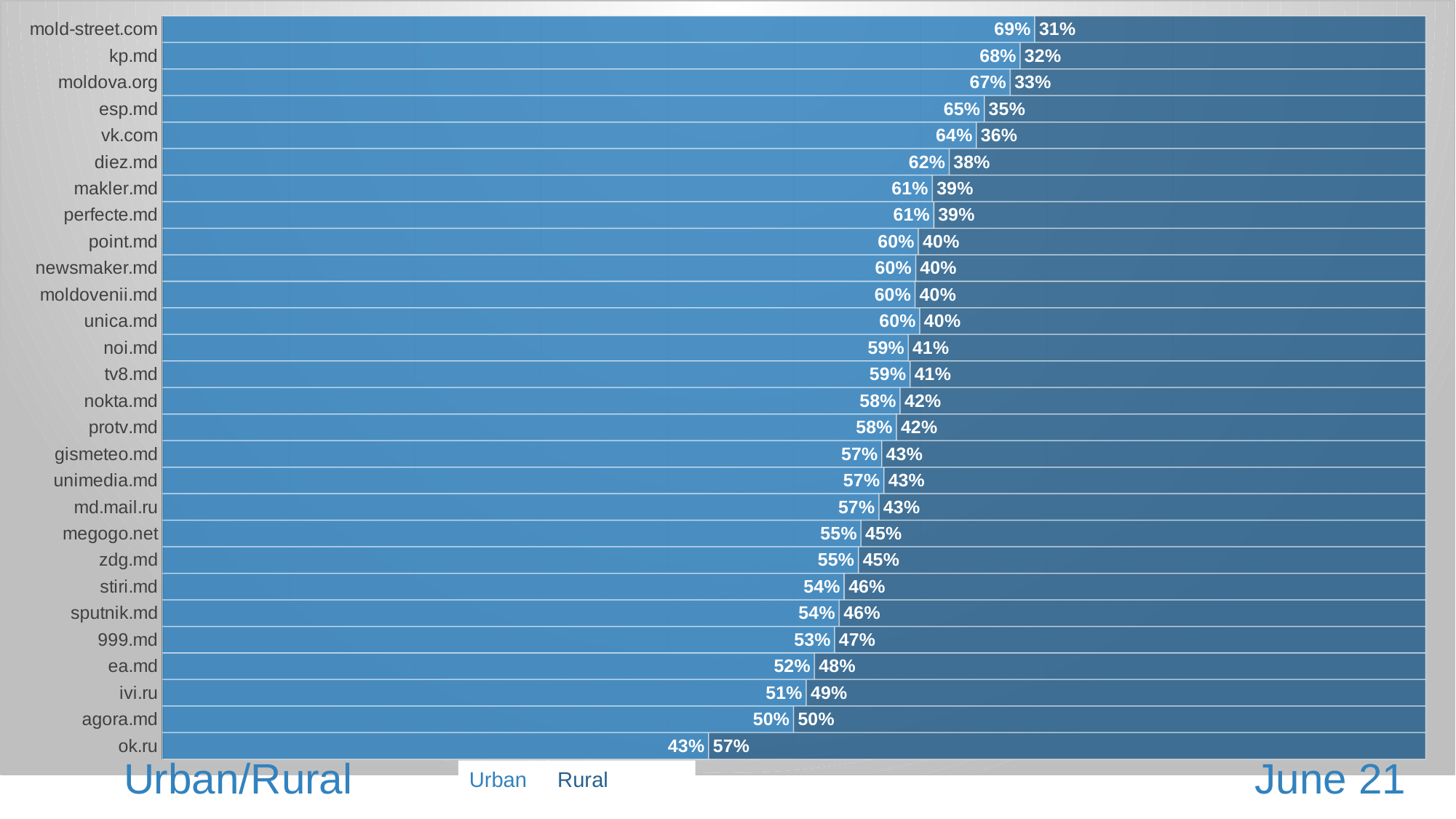
What is the Urban value for mold-street.com? 69% What is the Rural value for ok.ru? 57% What is the difference between the Urban and Rural values for kp.md? 36% What is the Urban value for agora.md? 50% What is the Rural value for vk.com? 36% Which site has the highest Urban share? mold-street.com Which is larger for diez.md, the Urban value or the Rural value? Urban What kind of chart is shown on the slide? Stacked bar chart Which site has the lowest Urban share? ok.ru How many series does the legend list? 2 How many sites are listed in the chart? 28 What is the total of the Urban and Rural values for esp.md? 100%